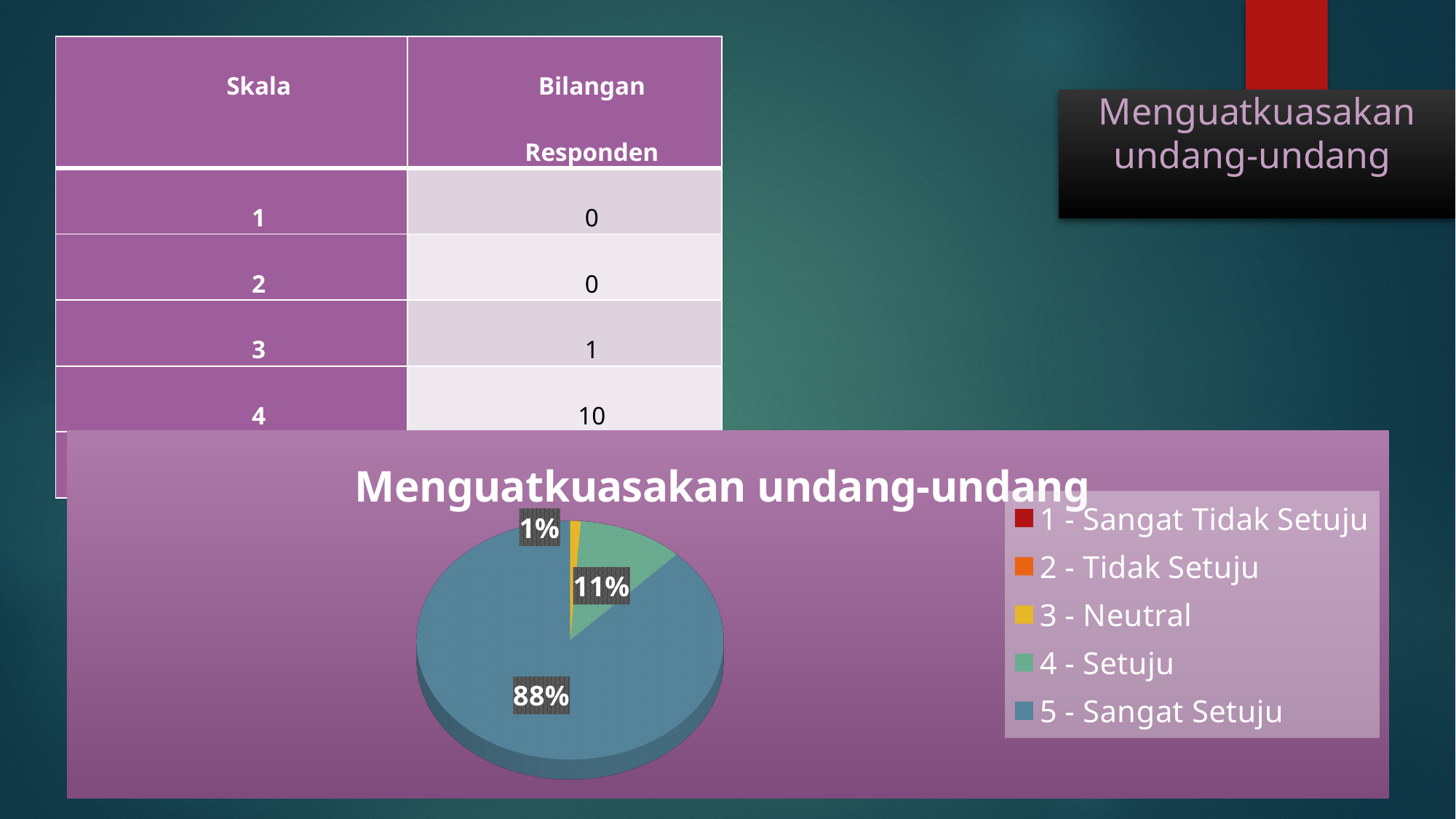
Which slice is larger, "4 - Setuju" or "3 - Neutral"? 4 - Setuju What share of the pie does the "3 - Neutral" slice represent? 1% What is the difference between the "5 - Sangat Setuju" share and the "4 - Setuju" share? 77% What share of the pie does the "4 - Setuju" slice represent? 11% How many slices in the pie have a percentage label? 3 What colour is the "5 - Sangat Setuju" slice in the legend? teal blue Which category has the largest slice of the pie? 5 - Sangat Setuju What share of the pie does the "5 - Sangat Setuju" slice represent? 88% What is the title of the chart? Menguatkuasakan undang-undang Which of the labelled slices is the smallest? 3 - Neutral What kind of chart is shown on the slide? pie chart How many entries does the chart's legend list? 5